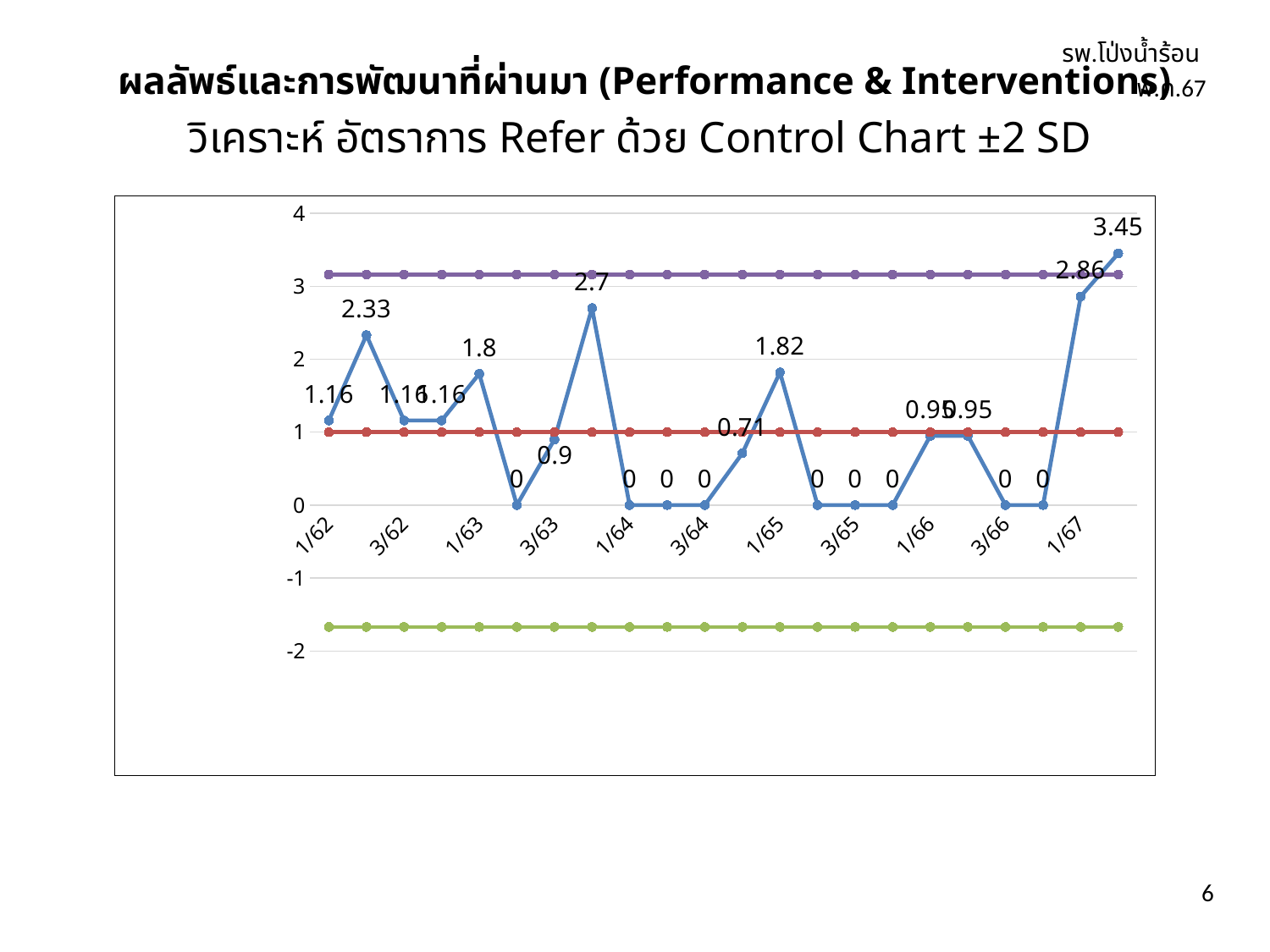
How many period labels are shown on the x axis? 11 Which has the larger value, 1/63 or 1/65? 1/65 What is the value plotted for 1/66? 0.95 What is the value plotted for 1/63? 1.8 What is the value plotted for 3/63? 0.9 What is the value plotted for 1/62? 1.16 What is the value plotted for 1/65? 1.82 What type of chart is shown on the slide? line chart What is the highest value labelled on the blue data line? 3.45 What is the difference between the values for 1/63 and 3/63? 0.9 What is the value plotted for 1/67? 2.86 How many horizontal reference lines (control limits and centre line) are drawn on the chart? 3